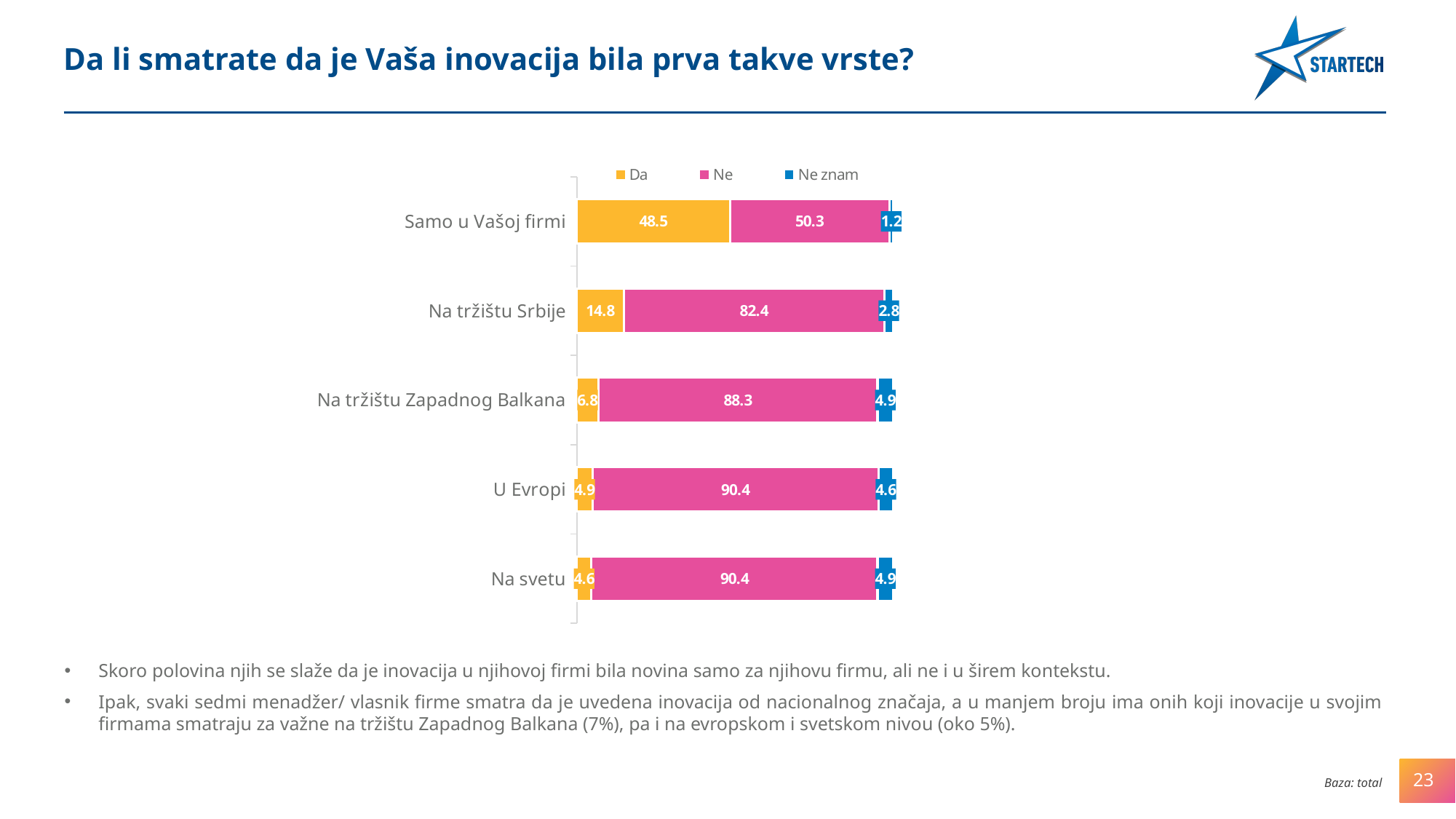
What is the "Ne znam" value for "Na tržištu Zapadnog Balkana"? 4.9 Which is larger for "Samo u Vašoj firmi": the "Da" value or the "Ne" value? Ne What is the difference between the "Ne" value and the "Da" value for "Na tržištu Srbije"? 67.6 What kind of chart is shown on the slide? Stacked bar chart How many categories are shown on the chart? 5 What is the "Ne" value for "Na tržištu Srbije"? 82.4 How many series does the legend list? 3 Which category has the lowest "Ne" value? Samo u Vašoj firmi What is the total of the stacked bar for "U Evropi"? 99.9 What is the "Da" value for "Samo u Vašoj firmi"? 48.5 What is the "Da" value for "Na svetu"? 4.6 Which category has the highest "Da" value? Samo u Vašoj firmi